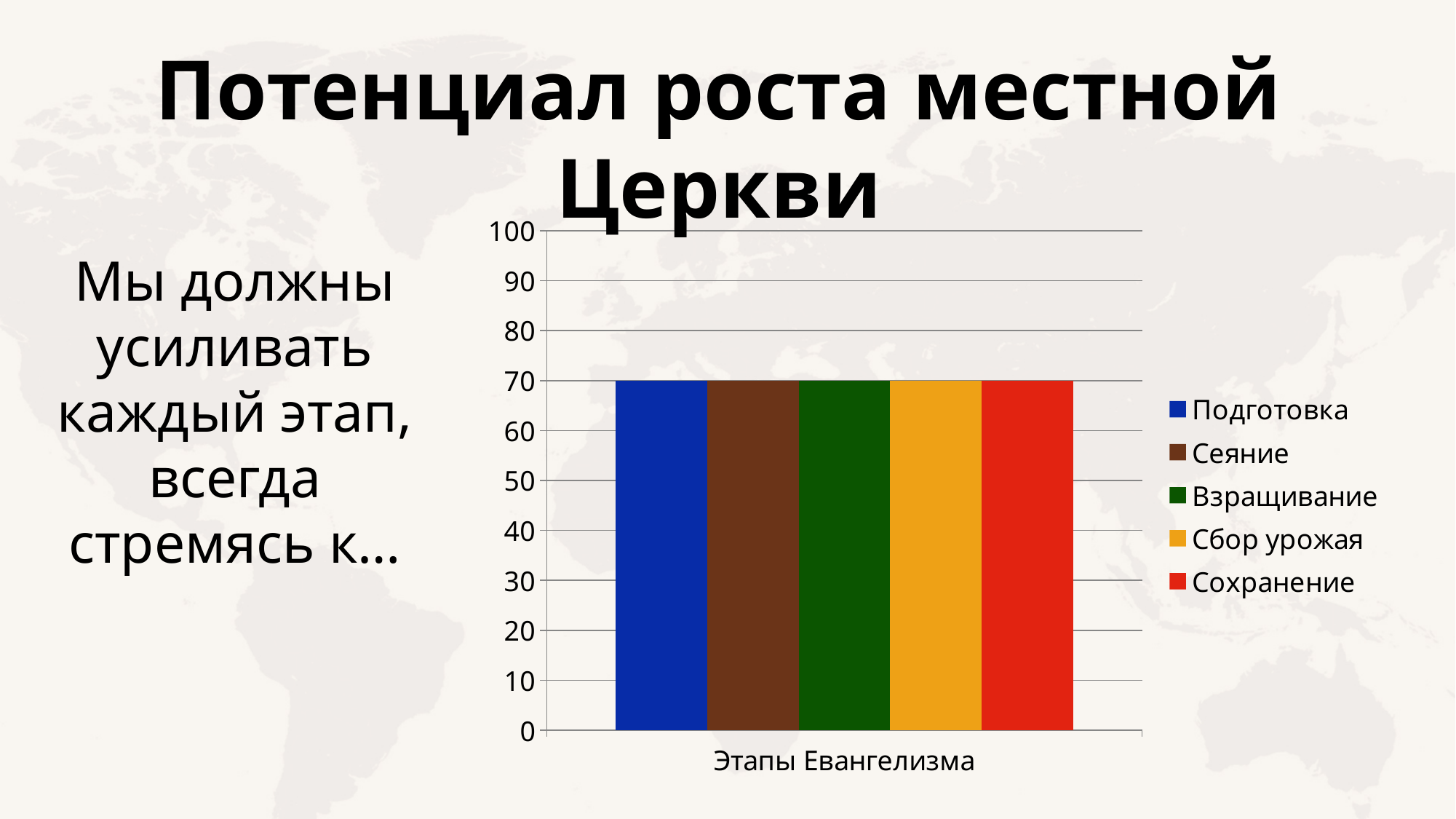
How many categories are shown on the x axis? 1 What is the value for Сохранение? 70 What is the value for Сеяние? 70 What is the value for Сбор урожая? 70 What kind of chart is shown on the slide? bar chart Is the value for Сохранение greater or less than 50? greater Is the value for Подготовка greater or less than 80? less How many series does the legend list? 5 What is the value for Подготовка? 70 What is the label on the x axis of the chart? Этапы Евангелизма What is the difference between the values for Подготовка and Сохранение? 0 What is the value for Взращивание? 70